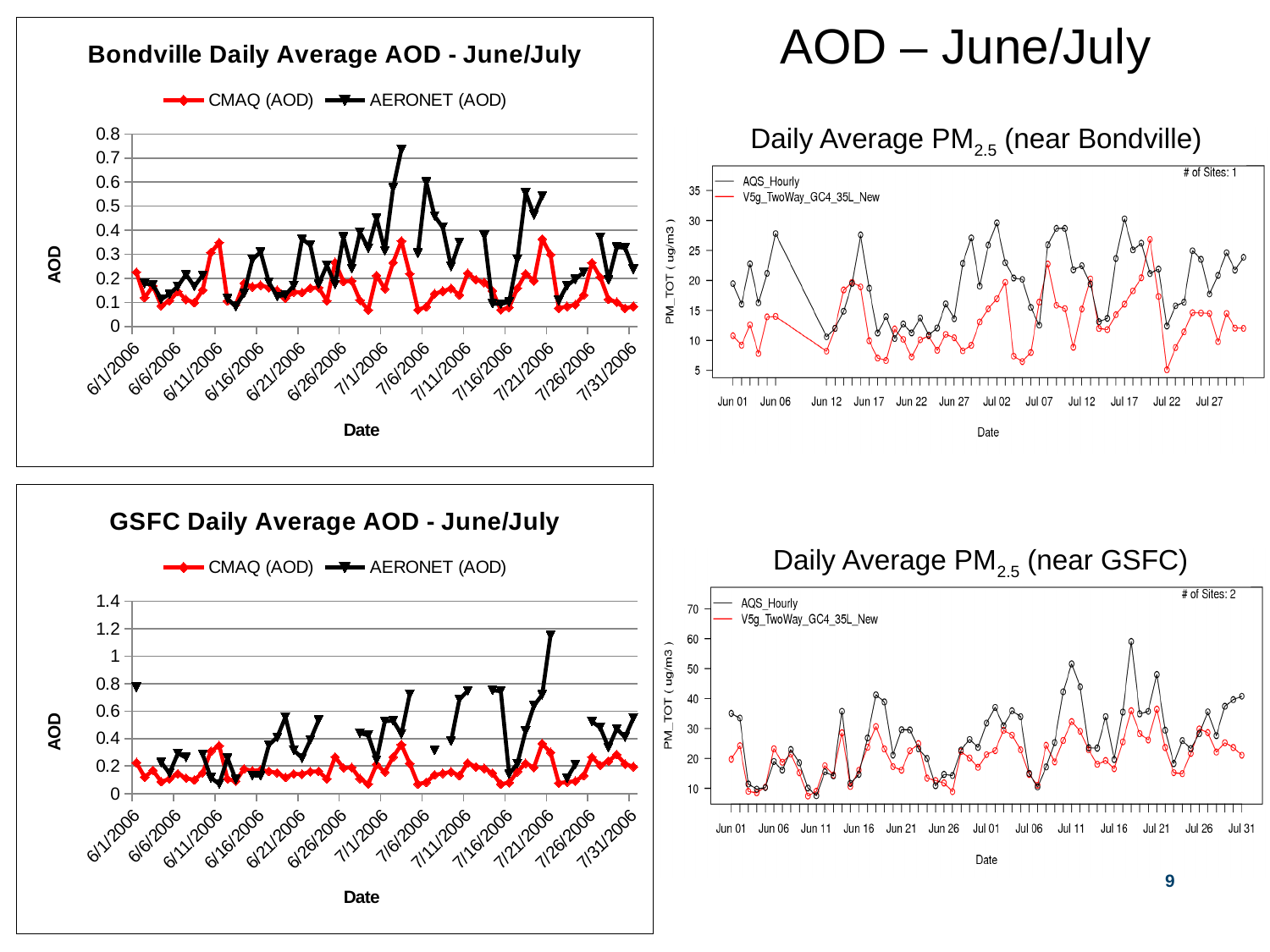
In the 'GSFC Daily Average AOD - June/July' chart, is the highest AERONET (AOD) value greater or less than 1.0? greater In the 'Daily Average PM2.5 (near Bondville)' chart, is the lowest V5g_TwoWay_GC4_35L_New value greater or less than 10? less In the 'Bondville Daily Average AOD - June/July' chart, which series reaches the higher maximum value, CMAQ (AOD) or AERONET (AOD)? AERONET (AOD) What type of chart is the 'Bondville Daily Average AOD - June/July' chart? line chart In the 'Daily Average PM2.5 (near GSFC)' chart, is the highest V5g_TwoWay_GC4_35L_New value greater or less than 40? less What are the two series named in the legend of the 'Bondville Daily Average AOD - June/July' chart? CMAQ (AOD) and AERONET (AOD) How many series does the legend of the 'GSFC Daily Average AOD - June/July' chart list? 2 In the 'Daily Average PM2.5 (near Bondville)' chart, which series reaches the higher maximum value, AQS_Hourly or V5g_TwoWay_GC4_35L_New? AQS_Hourly How many sites are indicated on the 'Daily Average PM2.5 (near GSFC)' chart? 2